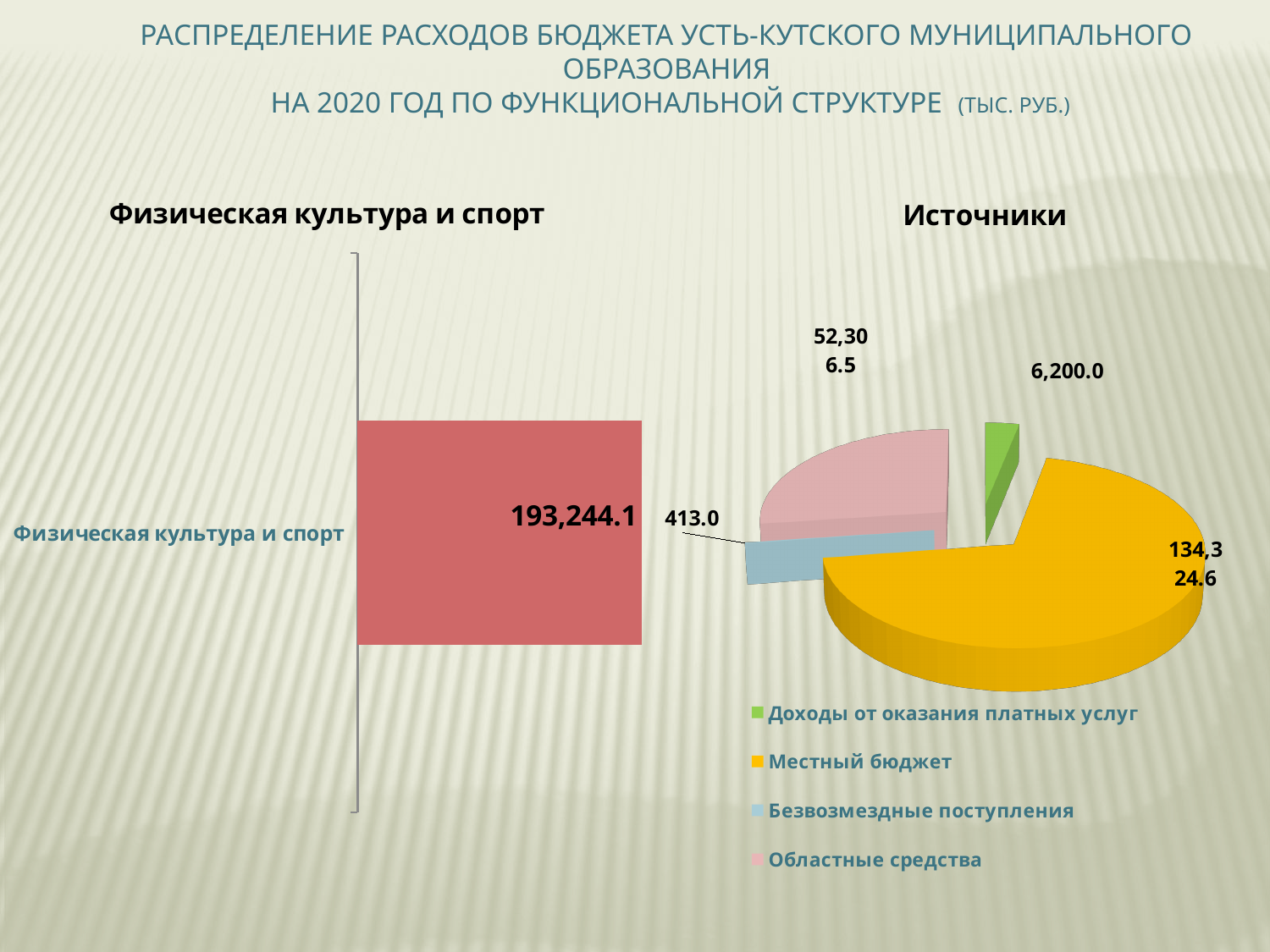
In the chart titled "Источники", what is the value for Местный бюджет? 134,324.6 In the chart titled "Источники", which is larger: Областные средства or Доходы от оказания платных услуг? Областные средства What kind of chart is the chart titled "Физическая культура и спорт"? bar chart What kind of chart is the chart titled "Источники"? pie chart In the chart titled "Источники", what is the value for Доходы от оказания платных услуг? 6,200.0 In the chart titled "Источники", which source has the largest slice? Местный бюджет In the chart titled "Источники", which source has the smallest slice? Безвозмездные поступления In the chart titled "Источники", what is the value for Безвозмездные поступления? 413.0 In the chart titled "Физическая культура и спорт", what is the value shown on the bar? 193,244.1 In the chart titled "Источники", what is the value for Областные средства? 52,306.5 How many bars are plotted in the chart titled "Физическая культура и спорт"? 1 How many entries does the legend of the chart titled "Источники" list? 4